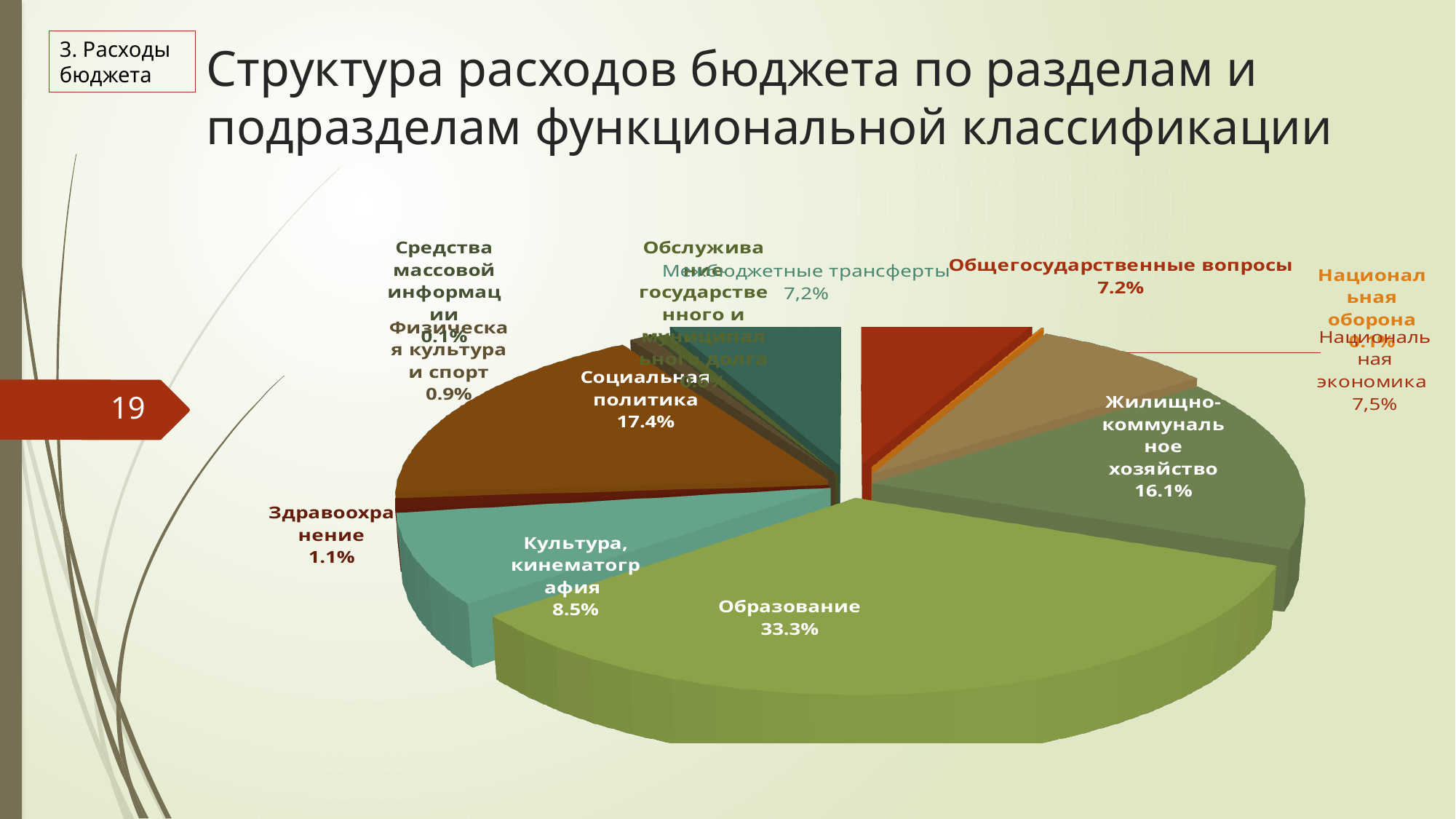
What is the value for Культура, кинематография? 8.5% What share is shown for Здравоохранение? 1.1% Which section has the largest share of budget expenditure? Образование What is the value for Физическая культура и спорт? 0.9% Which is larger, the share for Социальная политика or for Жилищно-коммунальное хозяйство? Социальная политика What is the title of the slide containing the chart? Структура расходов бюджета по разделам и подразделам функциональной классификации What percentage is shown for Жилищно-коммунальное хозяйство? 16.1% What kind of chart is shown on the slide? pie chart What is the value shown for Социальная политика? 17.4% By how many percentage points does Образование exceed Социальная политика? 15.9 What share of budget expenditure goes to Образование? 33.3% What percentage is shown for Национальная экономика? 7,5%